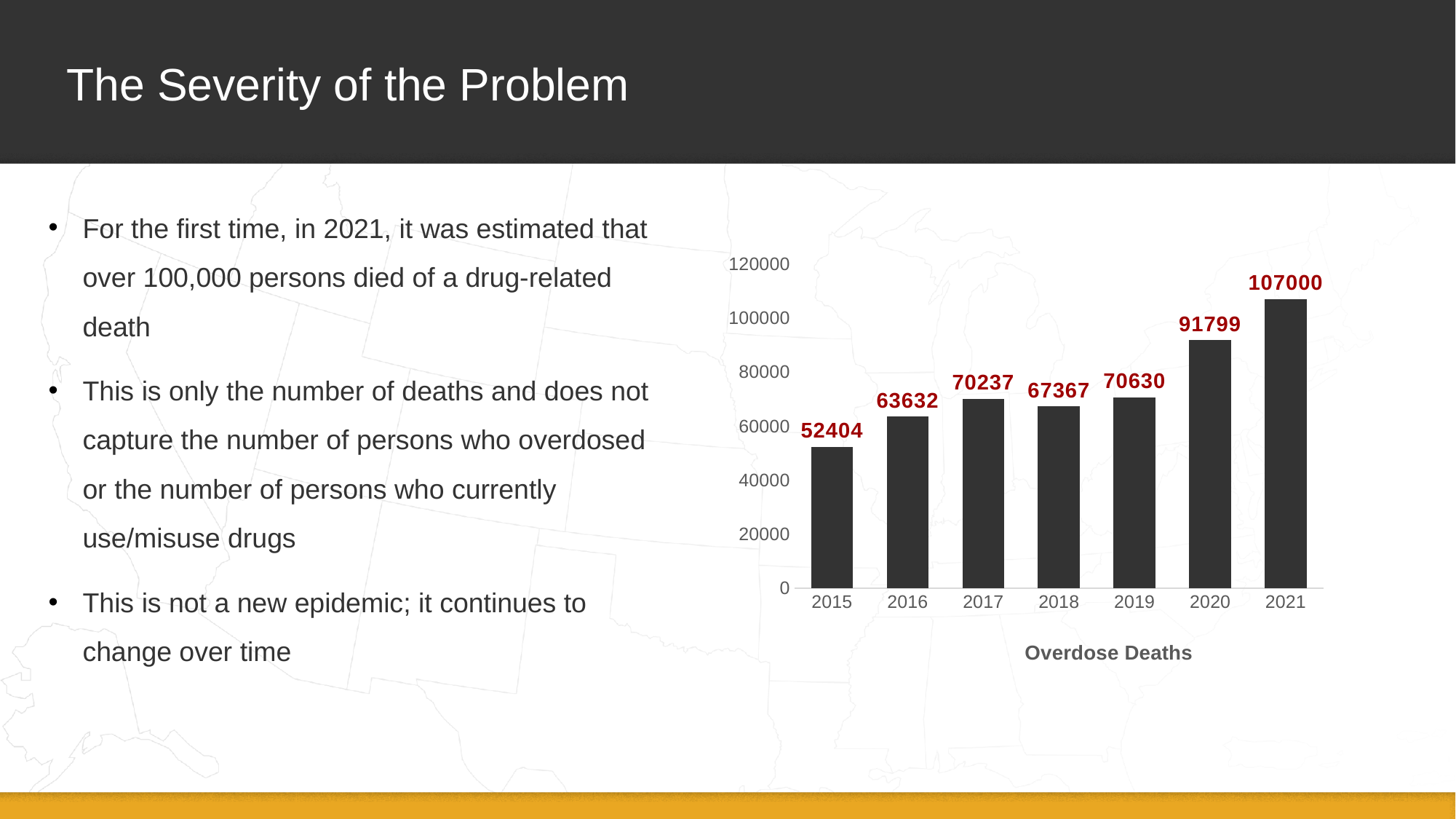
Is the value for 2020 in the Overdose Deaths chart greater or less than 80000? greater What is the value for 2015 in the Overdose Deaths chart? 52404 What is the difference between the 2021 and 2020 values in the Overdose Deaths chart? 15201 Which is larger in the Overdose Deaths chart, the value for 2017 or the value for 2018? 2017 How many years are shown in the Overdose Deaths chart? 7 What is the value for 2020 in the Overdose Deaths chart? 91799 What kind of chart is the Overdose Deaths chart? bar chart What is the value for 2018 in the Overdose Deaths chart? 67367 Which year has the highest value in the Overdose Deaths chart? 2021 Which year has the lowest value in the Overdose Deaths chart? 2015 Do the values in the Overdose Deaths chart generally rise or fall from 2015 to 2021? rise What is the difference between the 2016 and 2015 values in the Overdose Deaths chart? 11228